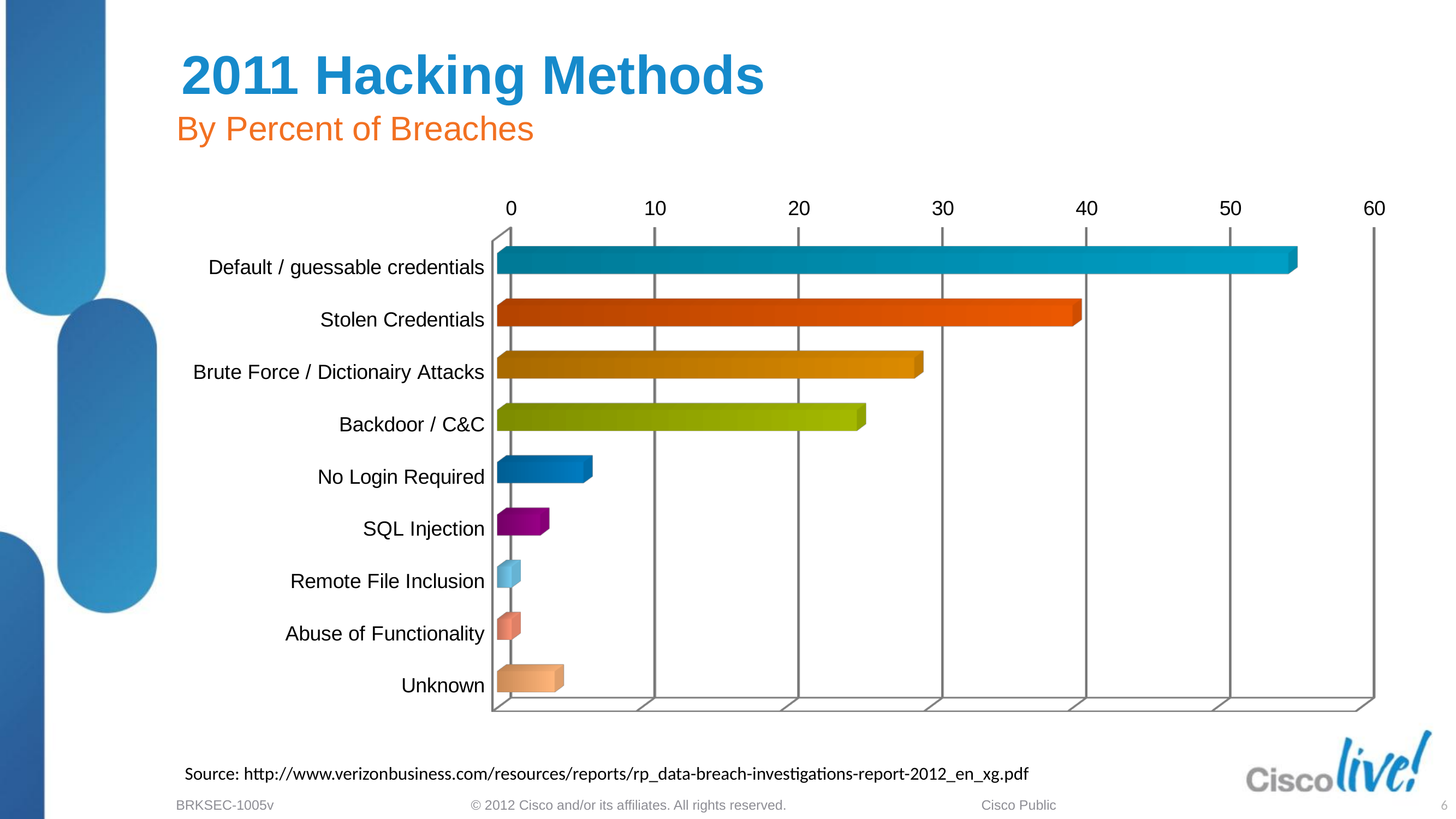
Is the value for No Login Required greater or less than 10? less Is the value for Backdoor / C&C greater or less than 20? greater Which is larger, the value for Stolen Credentials or the value for Backdoor / C&C? Stolen Credentials How many hacking methods (categories) are plotted in the chart? 9 What is the highest value shown on the horizontal axis? 60 What is the title of the chart slide? 2011 Hacking Methods Which is larger, the value for SQL Injection or the value for No Login Required? No Login Required Is the value for Default / guessable credentials greater or less than 50? greater Which hacking method has the highest percent of breaches? Default / guessable credentials What kind of chart is shown on the slide? bar chart Which is larger, the value for Unknown or the value for Remote File Inclusion? Unknown